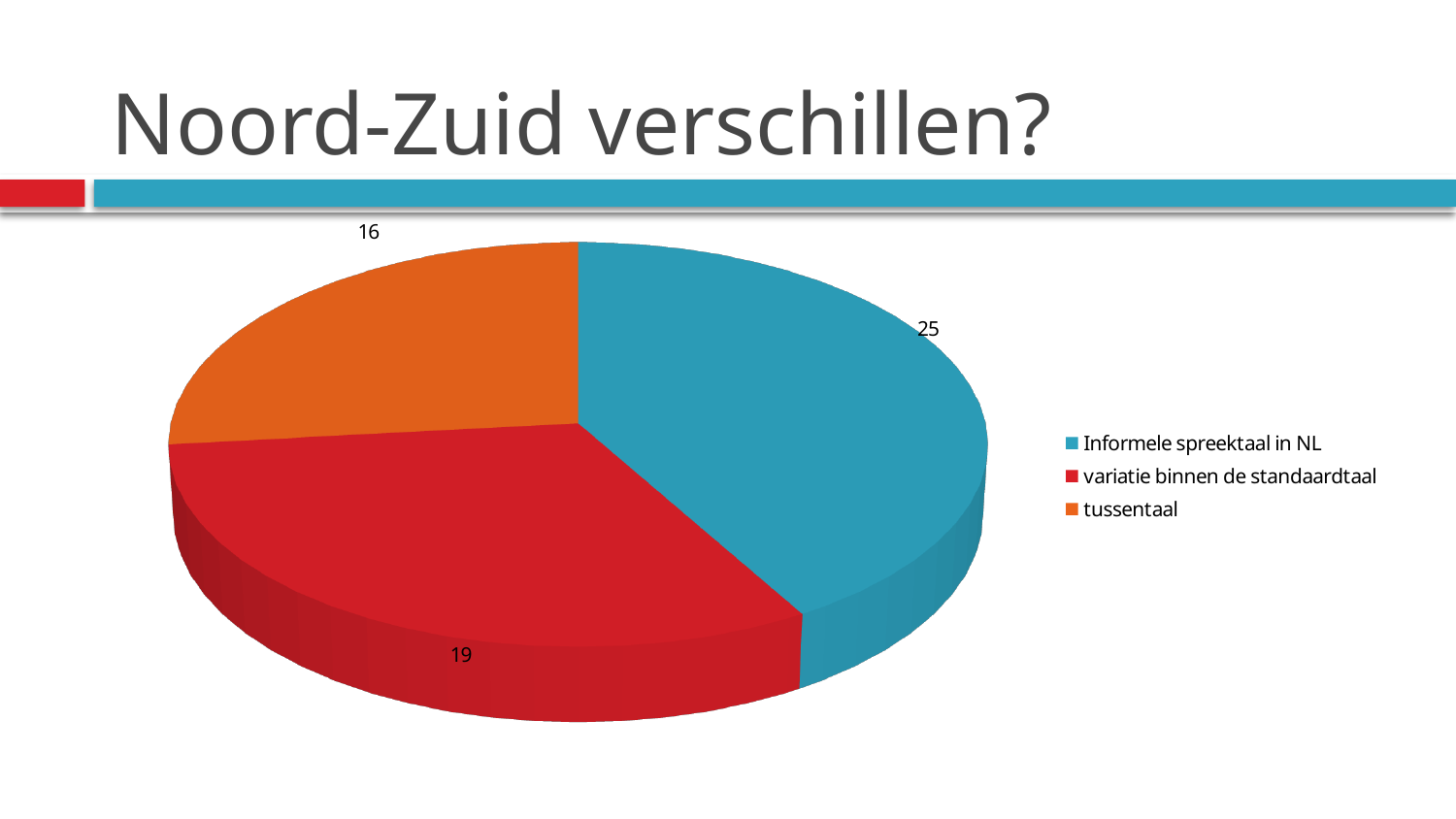
What colour is the slice for tussentaal? orange What is the value for tussentaal? 16 What is the difference between the values for variatie binnen de standaardtaal and tussentaal? 3 What kind of chart is shown on the slide? pie chart Which category has the largest slice of the pie? Informele spreektaal in NL What is the total of all the slices in the pie chart? 60 How many slices does the pie chart have? 3 What is the value for Informele spreektaal in NL? 25 Which is larger, the value for variatie binnen de standaardtaal or the value for tussentaal? variatie binnen de standaardtaal Which category has the smallest slice of the pie? tussentaal What is the difference between the values for Informele spreektaal in NL and tussentaal? 9 What is the value for variatie binnen de standaardtaal? 19